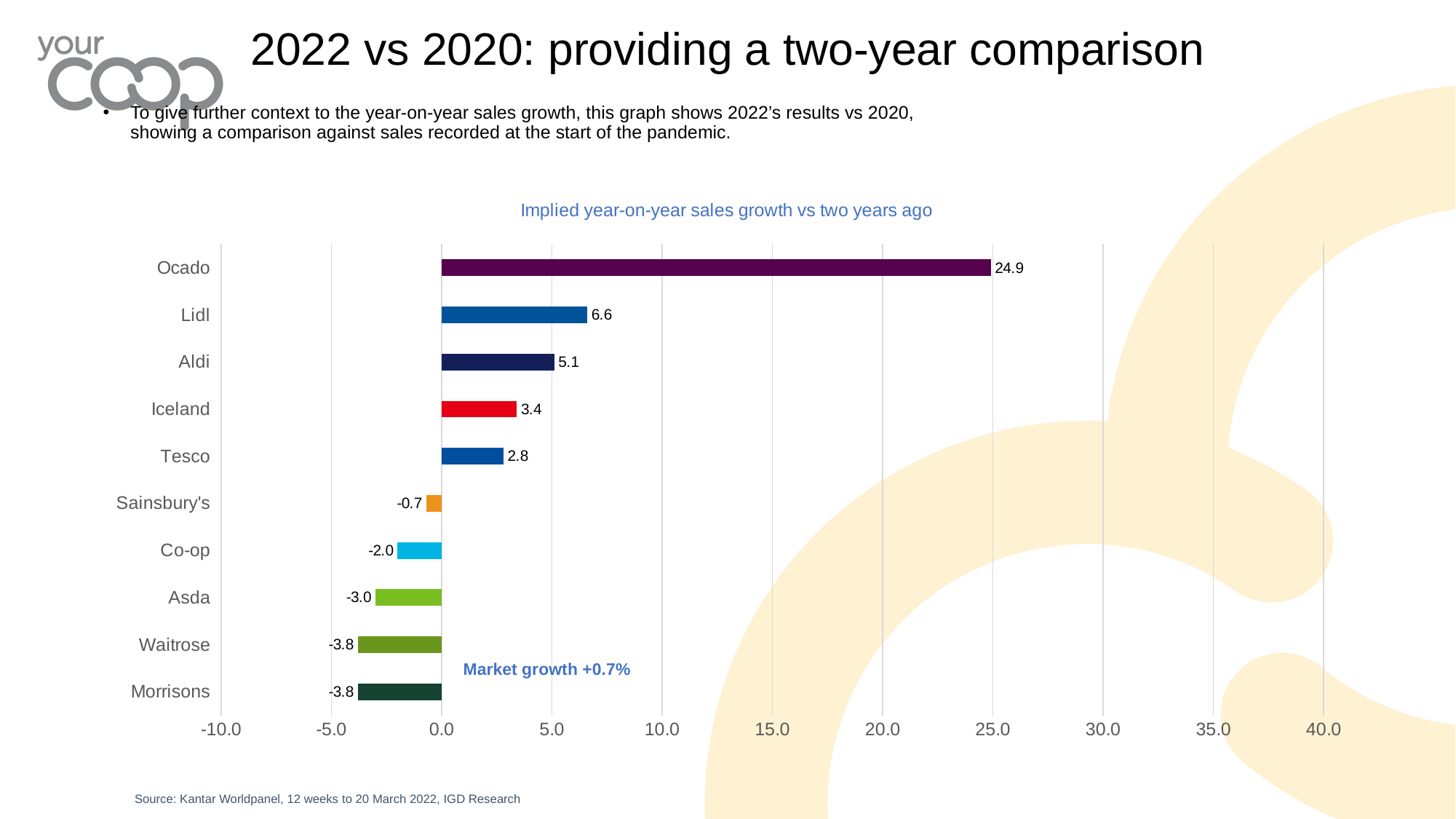
Which retailer has the highest value on the chart? Ocado What is the difference between the values for Lidl and Aldi? 1.5 How many retailers are shown on the chart? 10 What is the implied year-on-year sales growth vs two years ago for Ocado? 24.9 Which has the larger value, Iceland or Tesco? Iceland What kind of chart is shown on the slide? Bar chart What is the difference between the values for Ocado and Tesco? 22.1 What market growth figure is annotated on the chart? +0.7% What value is shown for Co-op? -2.0 What is the title of the chart? Implied year-on-year sales growth vs two years ago What value is shown for Sainsbury's? -0.7 Which has the larger value, Asda or Co-op? Co-op